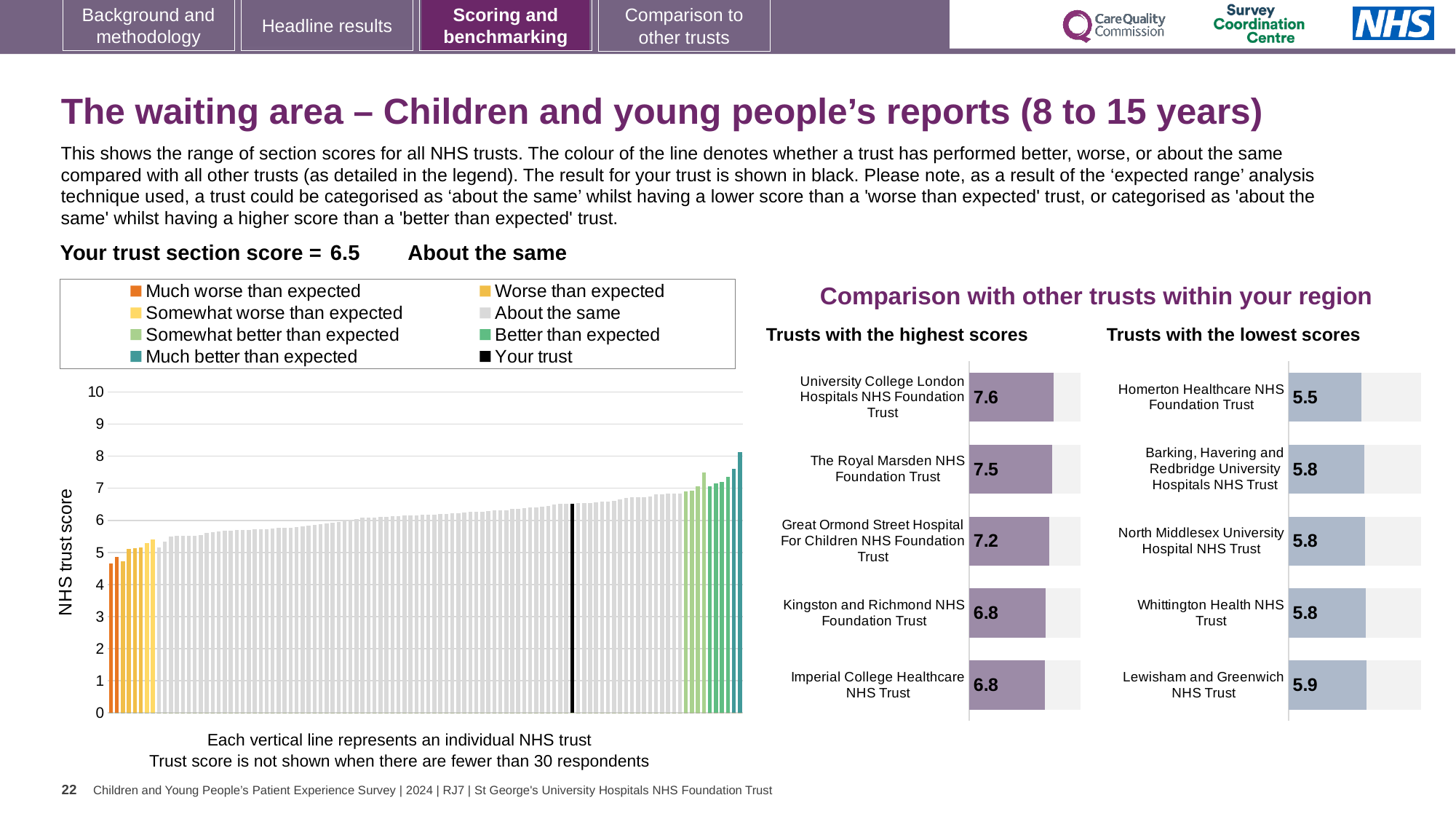
In the 'Trusts with the highest scores' chart, what is the difference between the scores of University College London Hospitals NHS Foundation Trust and Imperial College Healthcare NHS Trust? 0.8 In the 'Trusts with the lowest scores' chart, which trust has the lowest score? Homerton Healthcare NHS Foundation Trust How many entries does the legend of the NHS trust score chart on the left list? 8 In the 'Trusts with the highest scores' chart, what is the score for Great Ormond Street Hospital For Children NHS Foundation Trust? 7.2 In the NHS trust score chart on the left, do the trust scores rise or fall from left to right? rise In the 'Trusts with the lowest scores' chart, what is the score for Homerton Healthcare NHS Foundation Trust? 5.5 In the 'Trusts with the highest scores' chart, how many trusts are shown? 5 In the 'Trusts with the highest scores' chart, which trust has the highest score? University College London Hospitals NHS Foundation Trust In the NHS trust score chart on the left, what is the section score for your trust (the black bar)? 6.5 In the 'Trusts with the lowest scores' chart, which has the larger score: Lewisham and Greenwich NHS Trust or Homerton Healthcare NHS Foundation Trust? Lewisham and Greenwich NHS Trust In the 'Trusts with the highest scores' chart, what is the score for University College London Hospitals NHS Foundation Trust? 7.6 In the 'Trusts with the lowest scores' chart, what is the difference between the scores of Lewisham and Greenwich NHS Trust and Homerton Healthcare NHS Foundation Trust? 0.4